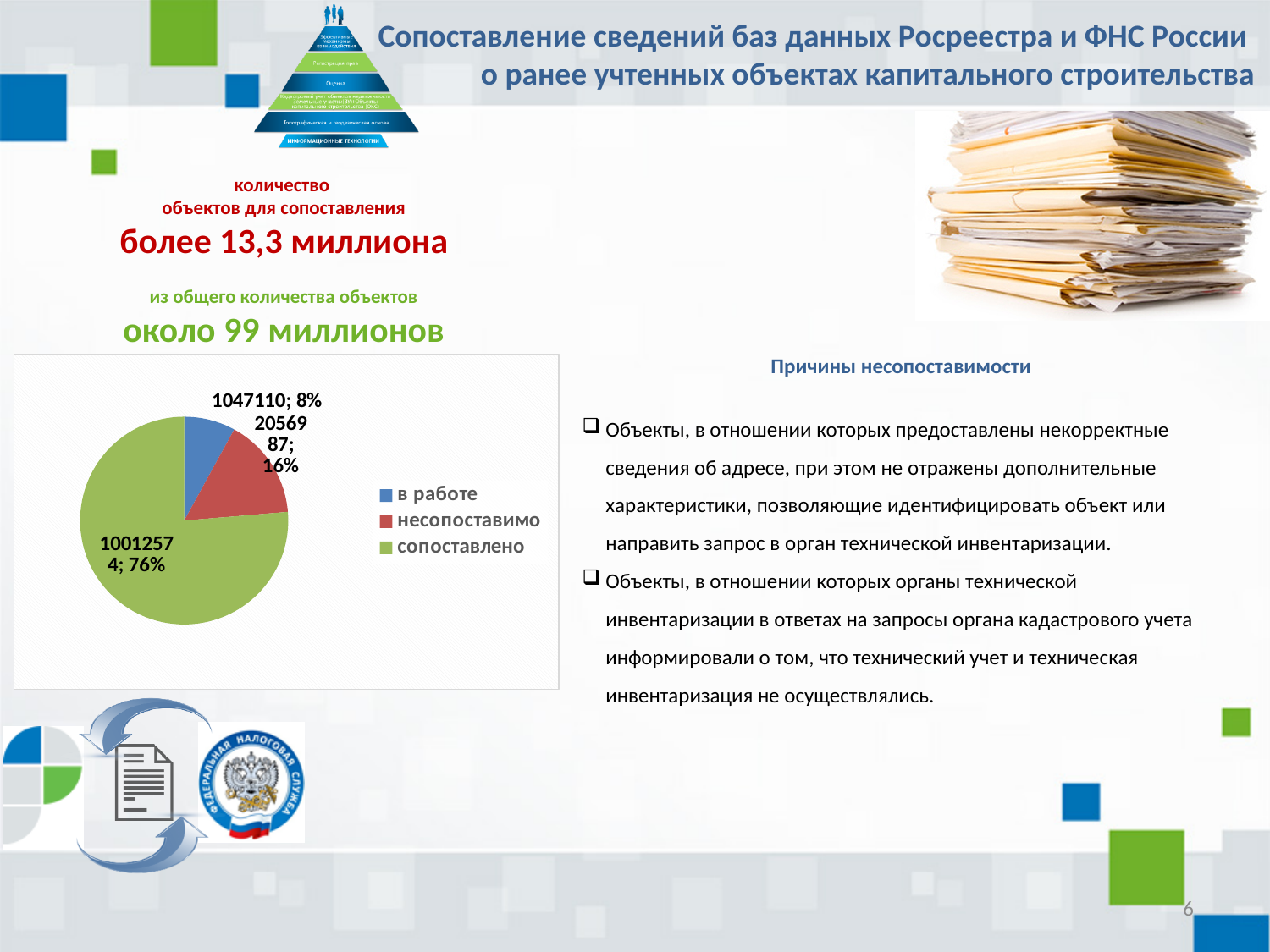
How many entries does the legend of the pie chart list? 3 What share of the pie does the "в работе" slice represent? 8% What colour is the "сопоставлено" slice in the pie chart? green What share of the pie does the "несопоставимо" slice represent? 16% Which is larger, the "несопоставимо" slice or the "в работе" slice? несопоставимо Which category has the largest slice in the pie chart? сопоставлено What is the difference in percentage points between the "сопоставлено" share and the "несопоставимо" share? 60 What kind of chart is shown on the slide? pie chart What share of the pie does the "сопоставлено" slice represent? 76% What is the value shown for the "в работе" slice? 1047110 How many slices does the pie chart have? 3 Which category has the smallest slice in the pie chart? в работе